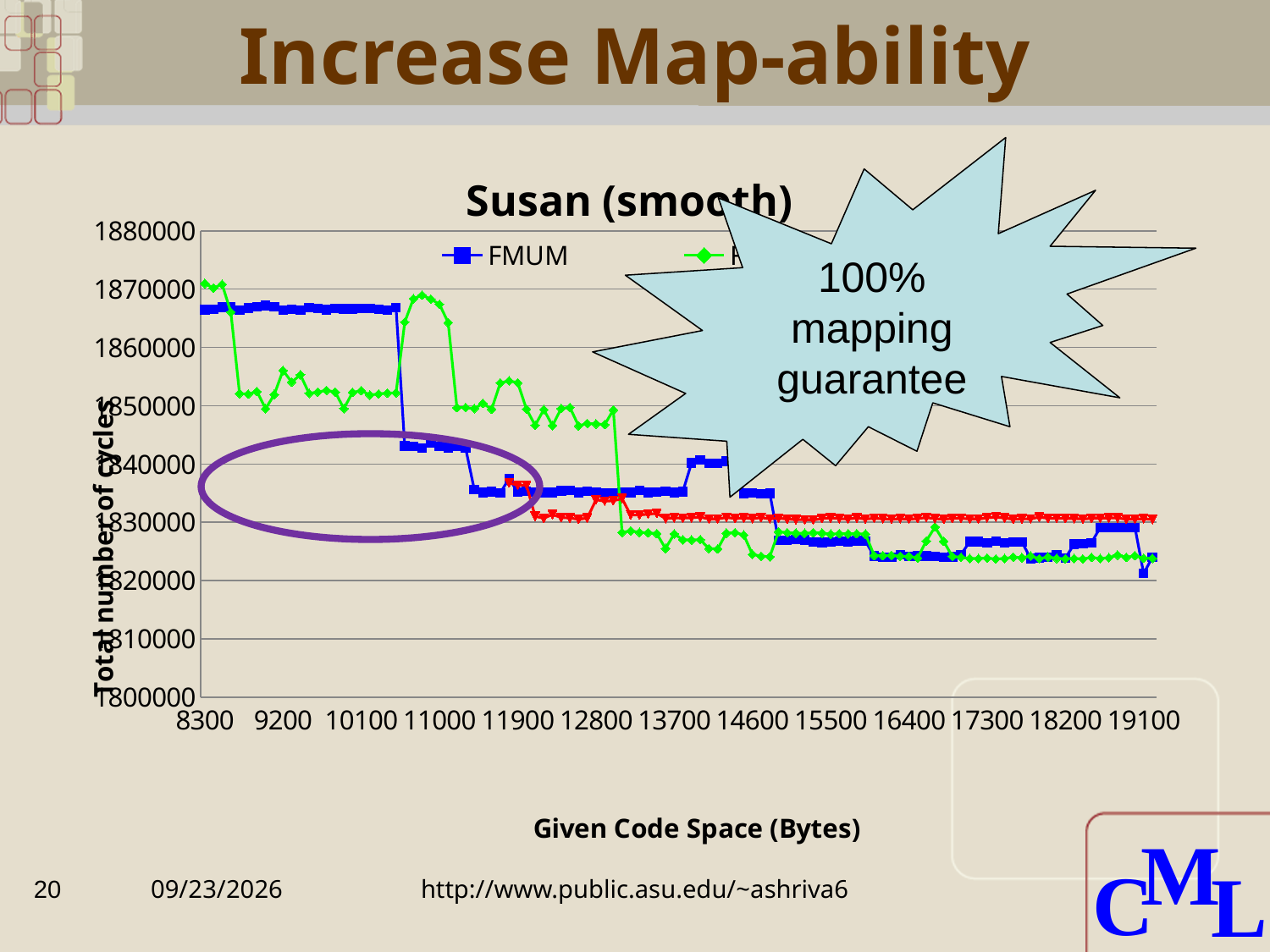
How many tick labels are shown on the x axis? 13 Overall, do the FMUM values rise or fall as the given code space increases? fall Is the FMUM value at a code space of 19100 greater or less than 1830000? less What is the title of the chart? Susan (smooth) Which is larger for the FMUM series: the value at 8300 or the value at 19100? 8300 Is the FMUM value at a code space of 8300 greater or less than 1860000? greater Is the FMUM value at a code space of 11900 greater or less than 1840000? less What is the label of the x axis of the chart? Given Code Space (Bytes) What is the lowest value labelled on the y axis? 1800000 What kind of chart is shown on the slide? line chart What is the highest value labelled on the y axis? 1880000